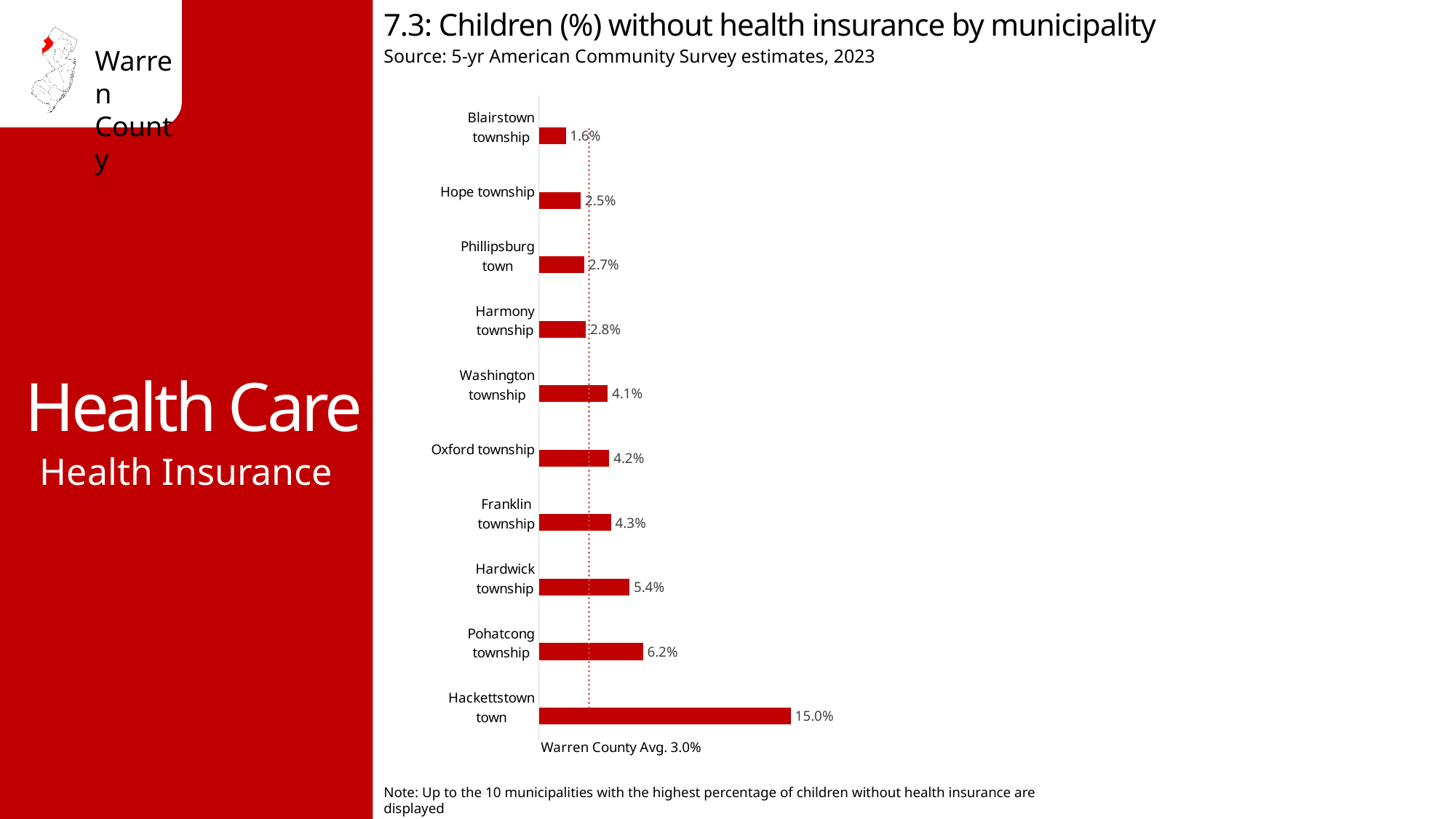
Which municipality has the highest percentage of children without health insurance? Hackettstown town What is the value shown for Hope township? 2.5% Which municipality has the lowest percentage of children without health insurance? Blairstown township What is the Warren County average shown on the chart? 3.0% What is the difference between the values for Hardwick township and Blairstown township? 3.8% How many municipalities are shown in the chart? 10 What is the title of the chart? 7.3: Children (%) without health insurance by municipality What is the difference between the values for Hackettstown town and Pohatcong township? 8.8% What percentage of children are without health insurance in Hackettstown town? 15.0% Which has a higher value, Oxford township or Phillipsburg town? Oxford township What is the value shown for Washington township? 4.1% What kind of chart is shown on the slide? Bar chart